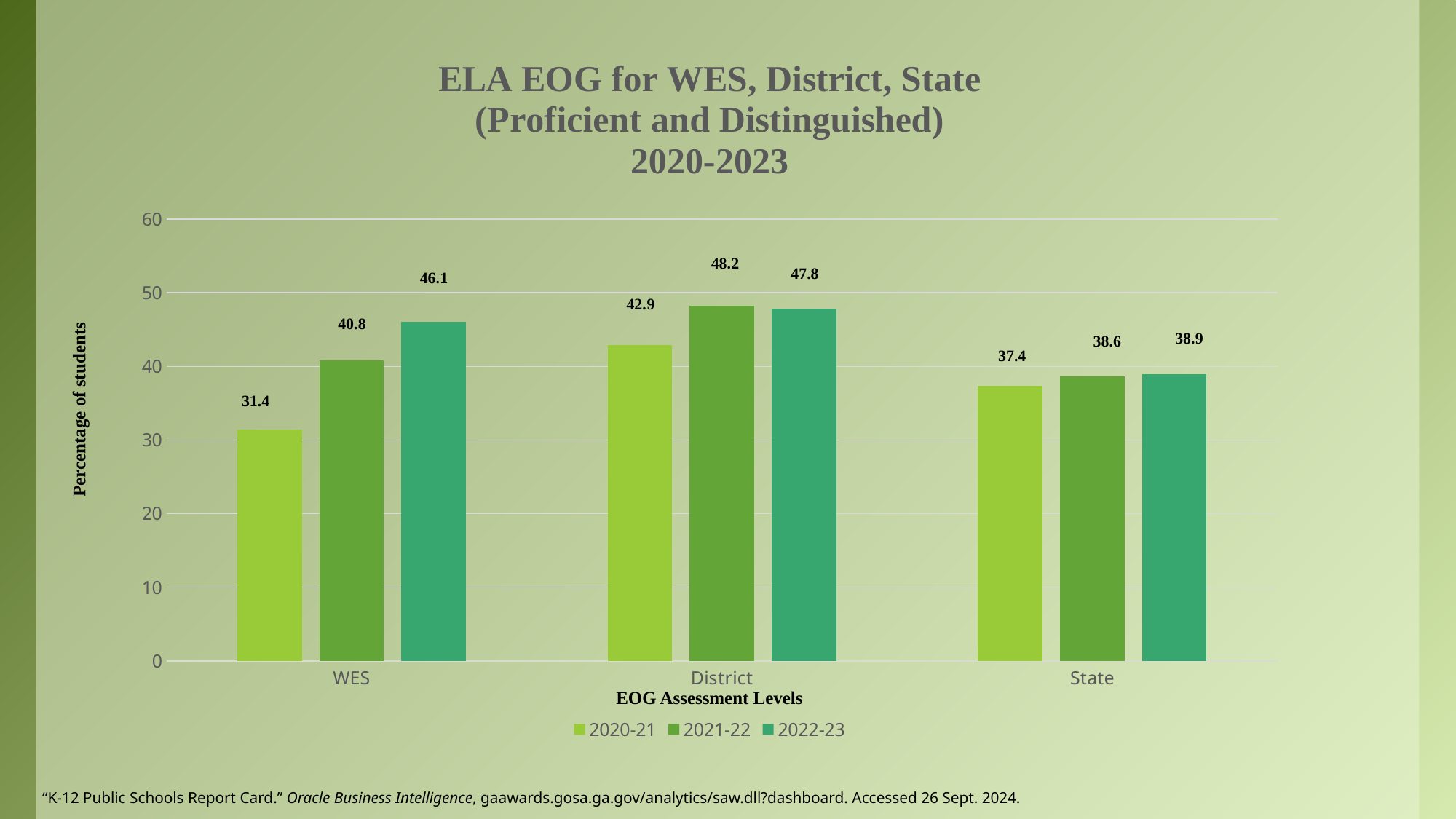
What is the value for WES in 2020-21? 31.4 Is the value for WES in 2021-22 greater or less than 50? less Which category has the lowest value in the 2020-21 series? WES What is the value for District in 2021-22? 48.2 What is the value for State in 2022-23? 38.9 Which is larger, the District value for 2021-22 or the District value for 2022-23? 2021-22 What kind of chart is shown on the slide? bar chart How many series does the legend list? 3 What is the label of the y axis? Percentage of students Which category has the highest value in the 2022-23 series? District What is the difference between the WES values for 2022-23 and 2020-21? 14.7 How many categories are shown on the x axis? 3